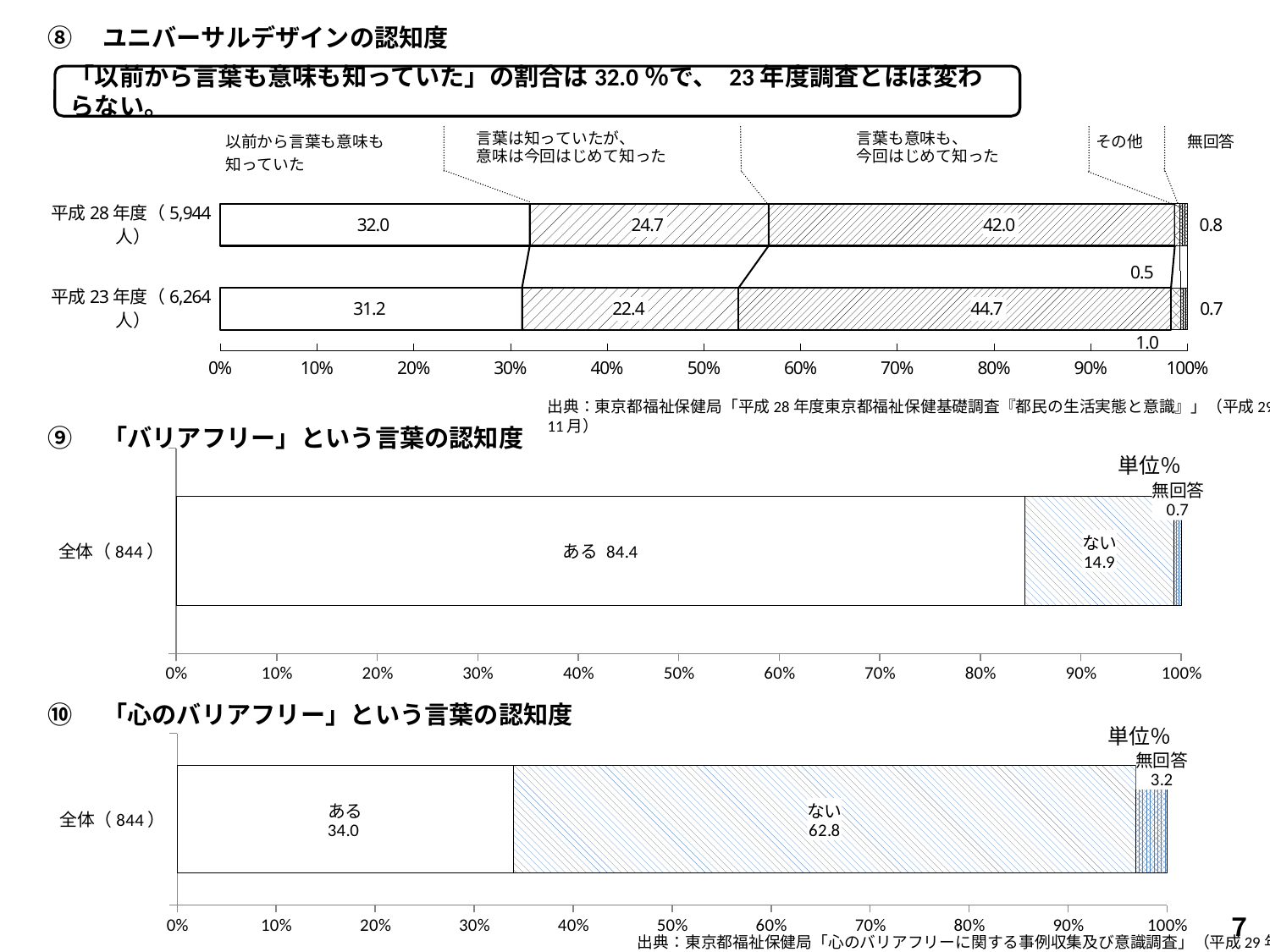
In the chart ⑧ ユニバーサルデザインの認知度, what is the value for 言葉も意味も、今回はじめて知った for 平成28年度? 42.0 In the chart ⑨ 「バリアフリー」という言葉の認知度, what is the value for 無回答? 0.7 In the chart ⑧ ユニバーサルデザインの認知度, which year has the larger value for 言葉は知っていたが、意味は今回はじめて知った, 平成28年度 or 平成23年度? 平成28年度 In the chart ⑧ ユニバーサルデザインの認知度, what is the value for 以前から言葉も意味も知っていた for 平成28年度? 32.0 In the chart ⑧ ユニバーサルデザインの認知度, which category has the largest share in the 平成23年度 bar? 言葉も意味も、今回はじめて知った In the chart ⑩ 「心のバリアフリー」という言葉の認知度, what is the difference between ない and ある? 28.8 In the chart ⑧ ユニバーサルデザインの認知度, how many survey years (bars) are shown? 2 In the chart ⑧ ユニバーサルデザインの認知度, what is the difference between the 言葉も意味も、今回はじめて知った values for 平成23年度 and 平成28年度? 2.7 In the chart ⑧ ユニバーサルデザインの認知度, what is the value for 言葉は知っていたが、意味は今回はじめて知った for 平成23年度? 22.4 In the chart ⑧ ユニバーサルデザインの認知度, how many categories does the legend list? 5 In the chart ⑨ 「バリアフリー」という言葉の認知度, what is the value for ある? 84.4 What kind of chart is ⑩ 「心のバリアフリー」という言葉の認知度? Stacked bar chart